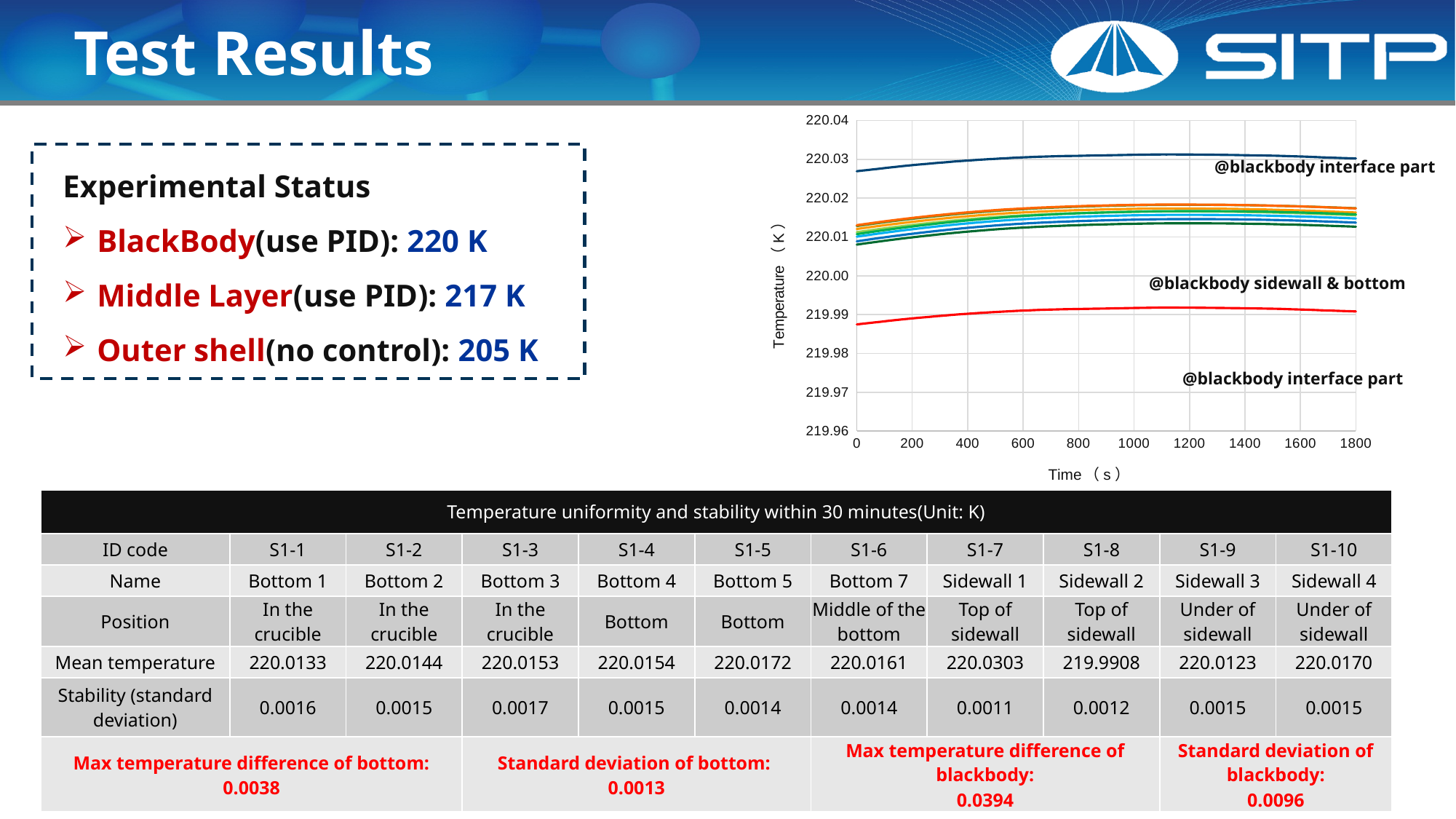
Does the red line rise or fall between 0 s and 600 s? rises Does the topmost line rise or fall between 0 s and 1800 s? rises Which is higher on the chart: the topmost line labelled '@blackbody interface part' or the red line? the topmost line labelled '@blackbody interface part' What is the label of the x axis of the chart? Time (s) Is the value of the red line at the bottom of the chart greater or less than 219.98? greater Is the topmost line above or below the lines labelled '@blackbody sidewall & bottom'? above What kind of chart is shown on the slide? line chart Is the value of the red line at the bottom of the chart greater or less than 220.00? less Are the lines labelled '@blackbody sidewall & bottom' greater or less than 220.00? greater What is the label of the y axis of the chart? Temperature (K)